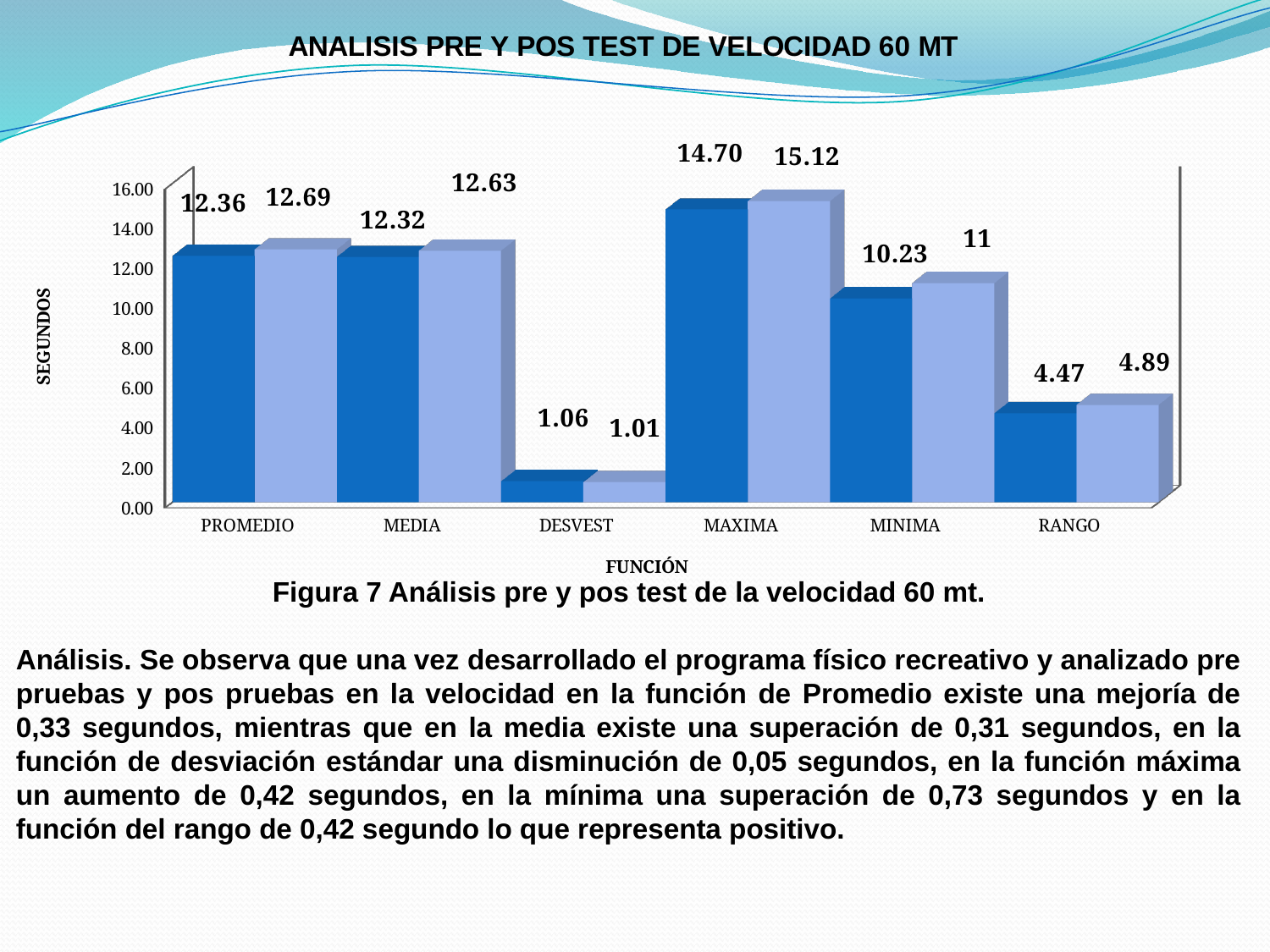
What is the title of the vertical axis of the chart? SEGUNDOS Which is larger for RANGO: the dark blue bar or the light blue bar? the light blue bar (4.89) Which category has the lowest value in the chart? DESVEST What is the difference between the light blue bar (12.69) and the dark blue bar (12.36) for PROMEDIO? 0.33 What is the value of the light blue (second) bar for MINIMA? 11 What type of chart is shown on the slide? bar chart What is the value of the light blue (second) bar for MAXIMA? 15.12 Which category has the highest value in the chart? MAXIMA What is the value of the dark blue (first) bar for PROMEDIO? 12.36 How many categories are shown on the x axis of the chart? 6 Is the value of the dark blue bar for MINIMA greater or less than 8.00? greater What is the value of the dark blue (first) bar for DESVEST? 1.06